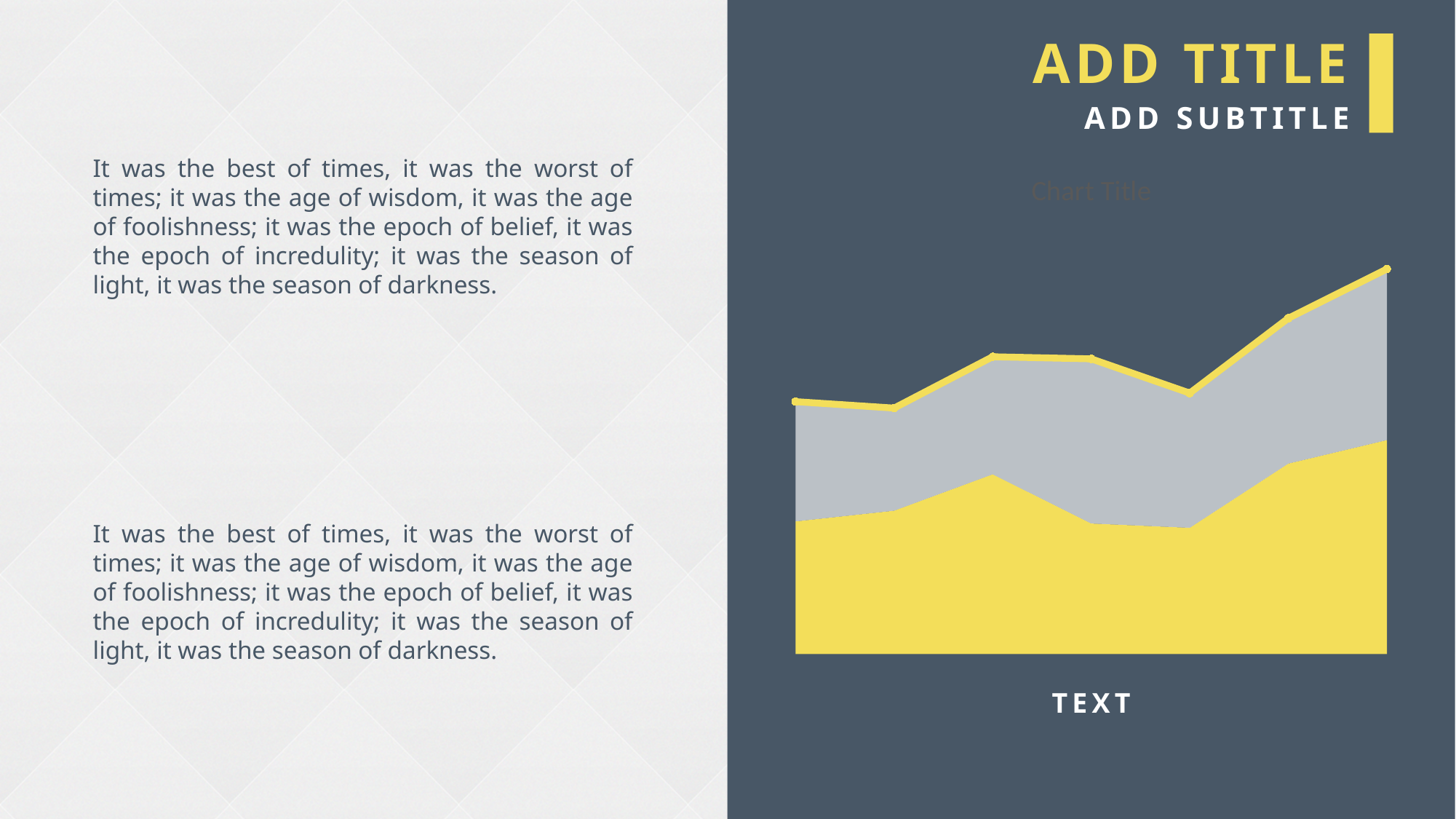
What is the title shown above the chart? Chart Title What colour is the bottom series in the stacked area chart? yellow Is the top line of the chart higher at the last point or at the first point? the last point How many data points does each series in the chart have? 7 How many series are plotted in the chart? 3 Does the yellow (bottom) series rise or fall overall from the first point to the last point? rise Does the top line of the stacked area chart rise or fall overall from left to right? rise At which point along the x axis does the top line of the chart reach its highest value? the last point What kind of chart is shown on the slide? area chart